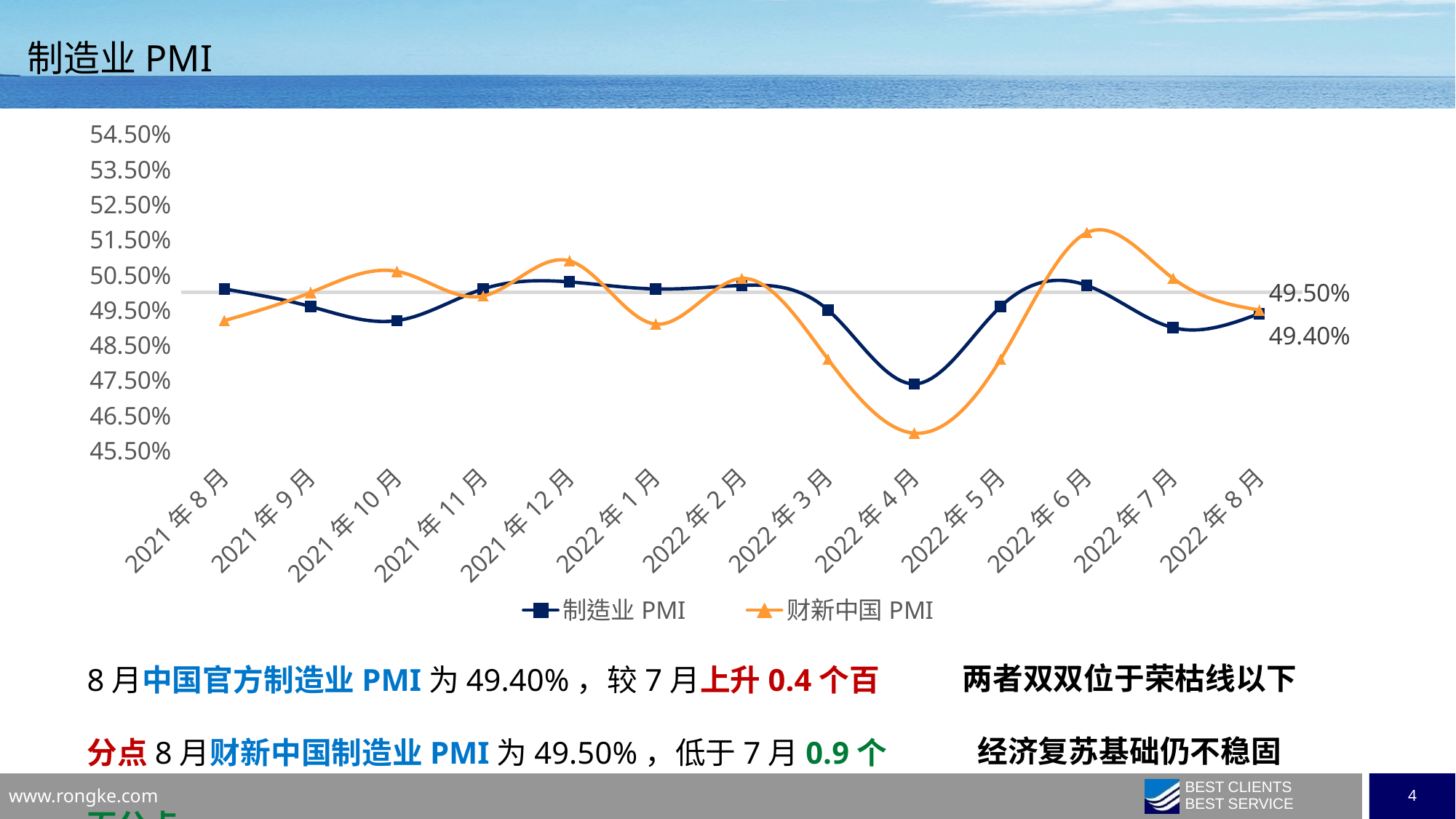
In which month is 财新中国 PMI at its highest? 2022年6月 Is the value of 财新中国 PMI for 2022年6月 greater or less than 50.50%? greater How many series does the legend list? 2 In which month is 制造业 PMI at its lowest? 2022年4月 How many months are plotted along the x axis? 13 What is the value of 财新中国 PMI for 2022年8月? 49.50% What kind of chart is shown on the slide? line chart Does 财新中国 PMI rise or fall from 2022年4月 to 2022年6月? rise Is the value of 财新中国 PMI for 2022年4月 greater or less than 47.50%? less What is the value of 制造业 PMI for 2022年8月? 49.40% What is the difference between 财新中国 PMI and 制造业 PMI in 2022年8月? 0.10% In 2022年8月, which series has the higher value, 制造业 PMI or 财新中国 PMI? 财新中国 PMI